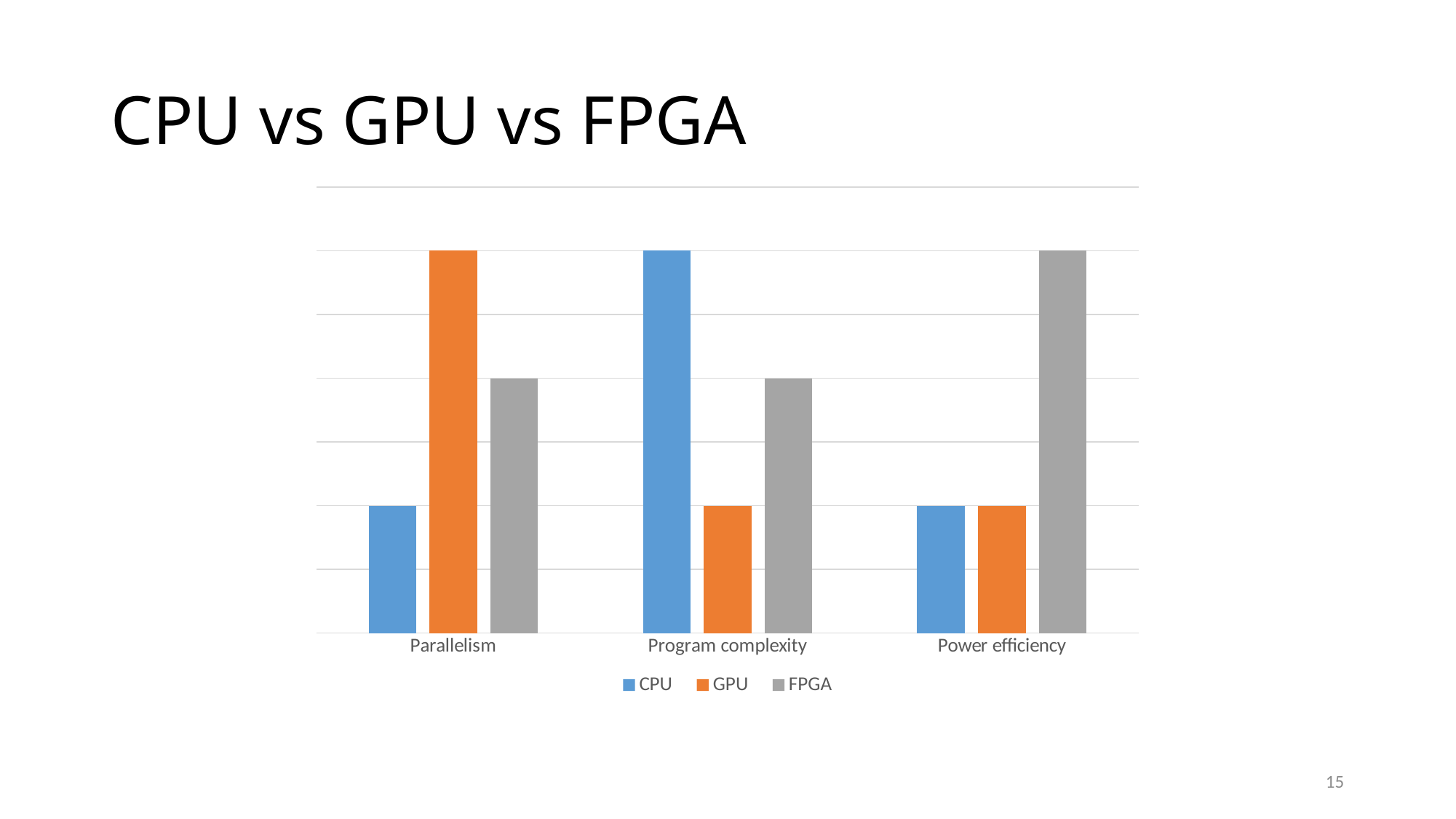
What is the title of the slide containing the chart? CPU vs GPU vs FPGA How many categories are shown on the x axis of the chart? 3 Which series has the highest bar for Program complexity? CPU Which series has the lowest bar for Parallelism? CPU How many series does the chart's legend list? 3 What kind of chart is shown on the slide? Bar chart Which series has the lowest bar for Program complexity? GPU For Program complexity, which is larger: the CPU bar or the FPGA bar? CPU Which series has the highest bar for Parallelism? GPU Which series has the highest bar for Power efficiency? FPGA What colour represents the FPGA series in the chart? Grey For Parallelism, which is larger: the GPU bar or the FPGA bar? GPU